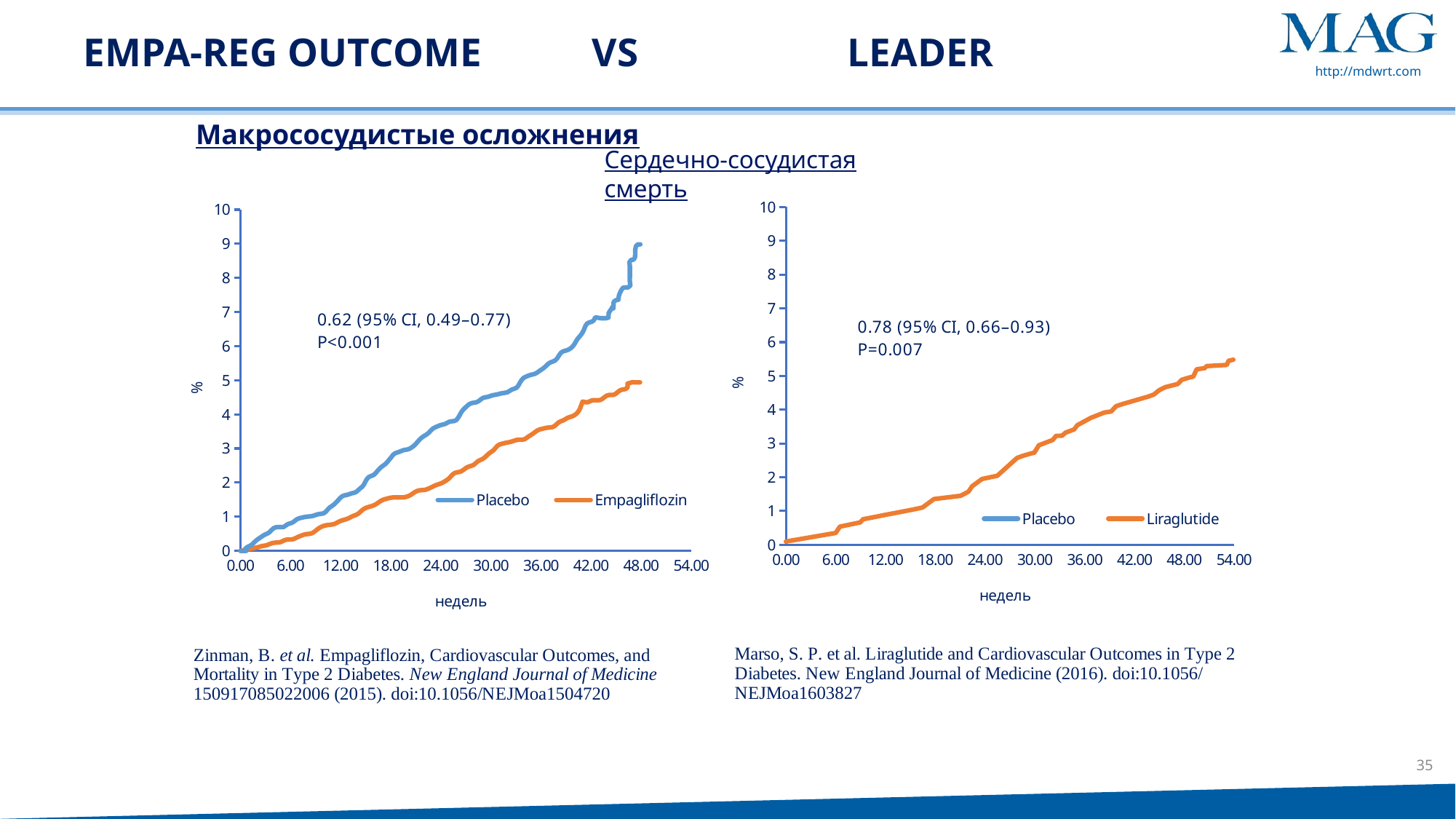
In the right chart (LEADER), do the Liraglutide values rise or fall as the weeks increase? rise In the left chart (EMPA-REG OUTCOME), is the Placebo value at 48.00 weeks greater or less than 8? greater In the left chart (EMPA-REG OUTCOME), is the Placebo value at 24.00 weeks greater or less than 3? greater What kind of chart is the right chart (LEADER)? line chart How many series does the legend of the right chart (LEADER) list? 2 In the right chart (LEADER), is the Liraglutide value at 36.00 weeks greater or less than 3? greater In the left chart (EMPA-REG OUTCOME), which series is higher at 48.00 weeks, Placebo or Empagliflozin? Placebo What kind of chart is the left chart (EMPA-REG OUTCOME)? line chart How many series does the legend of the left chart (EMPA-REG OUTCOME) list? 2 What is the label on the x axis of the left chart (EMPA-REG OUTCOME)? недель